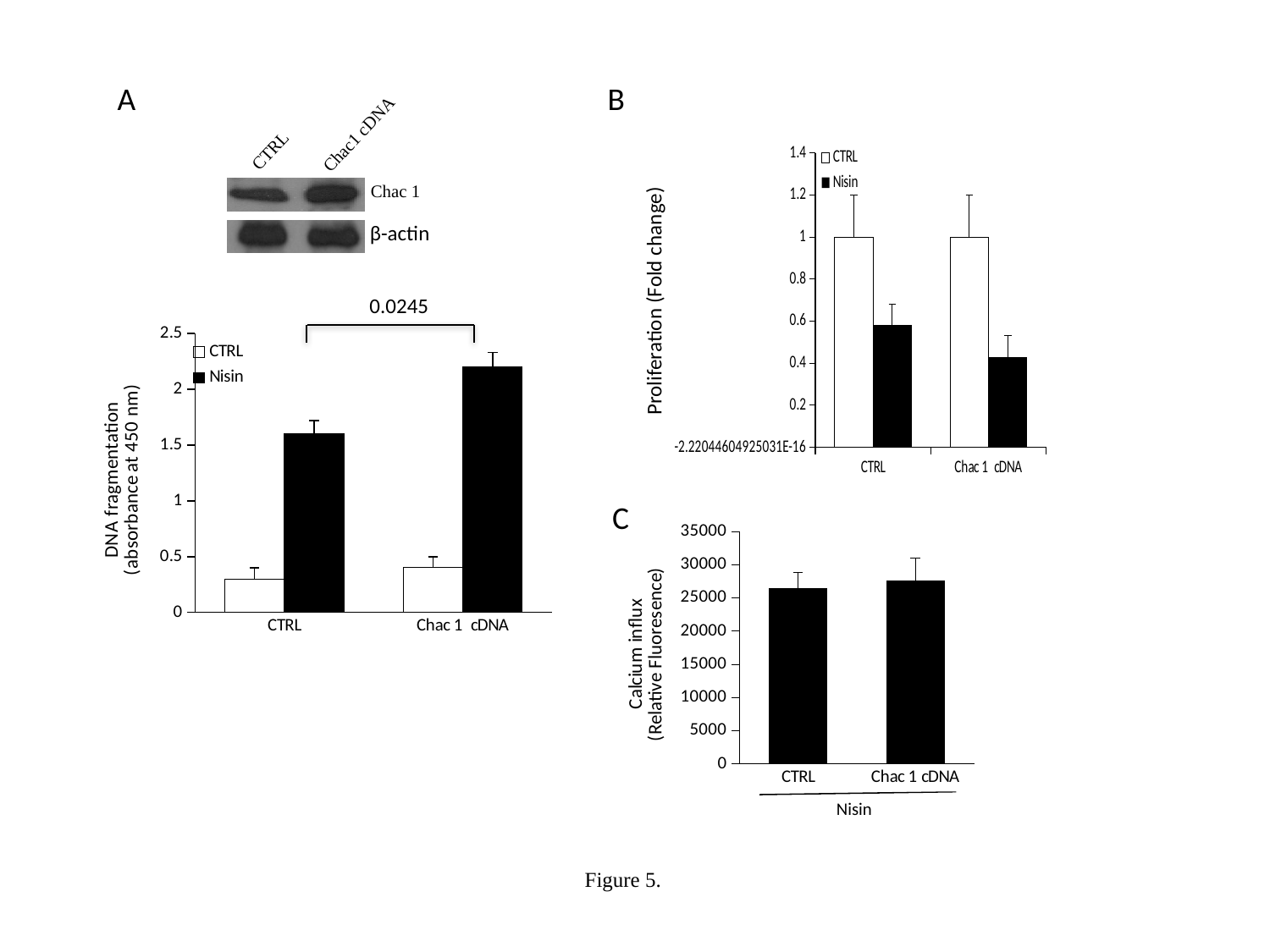
In the DNA fragmentation chart (panel A), what kind of chart is shown? bar chart In the DNA fragmentation chart (panel A), what p-value is printed above the bracket comparing the two Nisin bars? 0.0245 In the DNA fragmentation chart (panel A), is the CTRL-series value for CTRL greater or less than 0.5? less In the Proliferation chart (panel B), what is the CTRL-series value for Chac 1 cDNA? 1 In the DNA fragmentation chart (panel A), which is larger: the Nisin value for CTRL or the Nisin value for Chac 1 cDNA? Chac 1 cDNA In the Calcium influx chart (panel C), is the value for CTRL greater or less than 25000? greater In the DNA fragmentation chart (panel A), how many series does the legend list? 2 In the Proliferation chart (panel B), is the Nisin value for Chac 1 cDNA greater or less than 0.6? less In the Proliferation chart (panel B), what is the CTRL-series value for the CTRL category? 1 In the Calcium influx chart (panel C), how many categories are plotted? 2 In the Proliferation chart (panel B), which is larger: the Nisin value for CTRL or the Nisin value for Chac 1 cDNA? CTRL